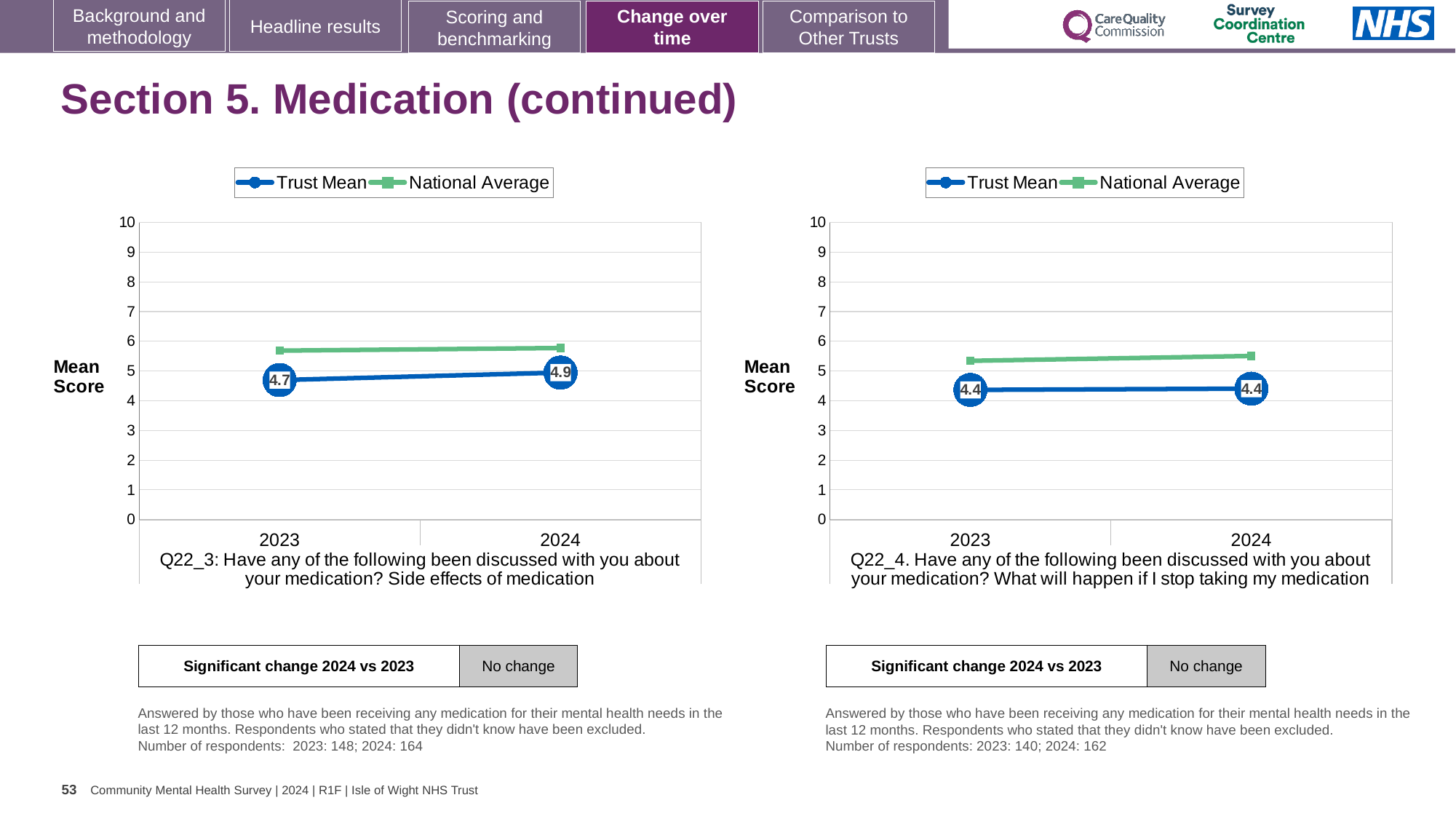
What kind of chart is used for Q22_3? Line chart In the right chart (Q22_4), what is the Trust Mean for 2024? 4.4 How many series does the legend of the left chart list? 2 In the right chart (Q22_4), which series is higher in 2023, Trust Mean or National Average? National Average In the left chart (Q22_3), which year has the higher Trust Mean? 2024 In the left chart (Q22_3), what is the Trust Mean for 2024? 4.9 In the left chart (Q22_3), what is the Trust Mean for 2023? 4.7 In the left chart (Q22_3), does the Trust Mean rise or fall from 2023 to 2024? Rise How many years are plotted on the x axis of the right chart (Q22_4)? 2 In the left chart (Q22_3), is the National Average for 2023 greater or less than 5? greater In the right chart (Q22_4), is the National Average for 2024 greater or less than 5? greater In the left chart (Q22_3), what is the difference between the Trust Mean for 2024 and 2023? 0.2